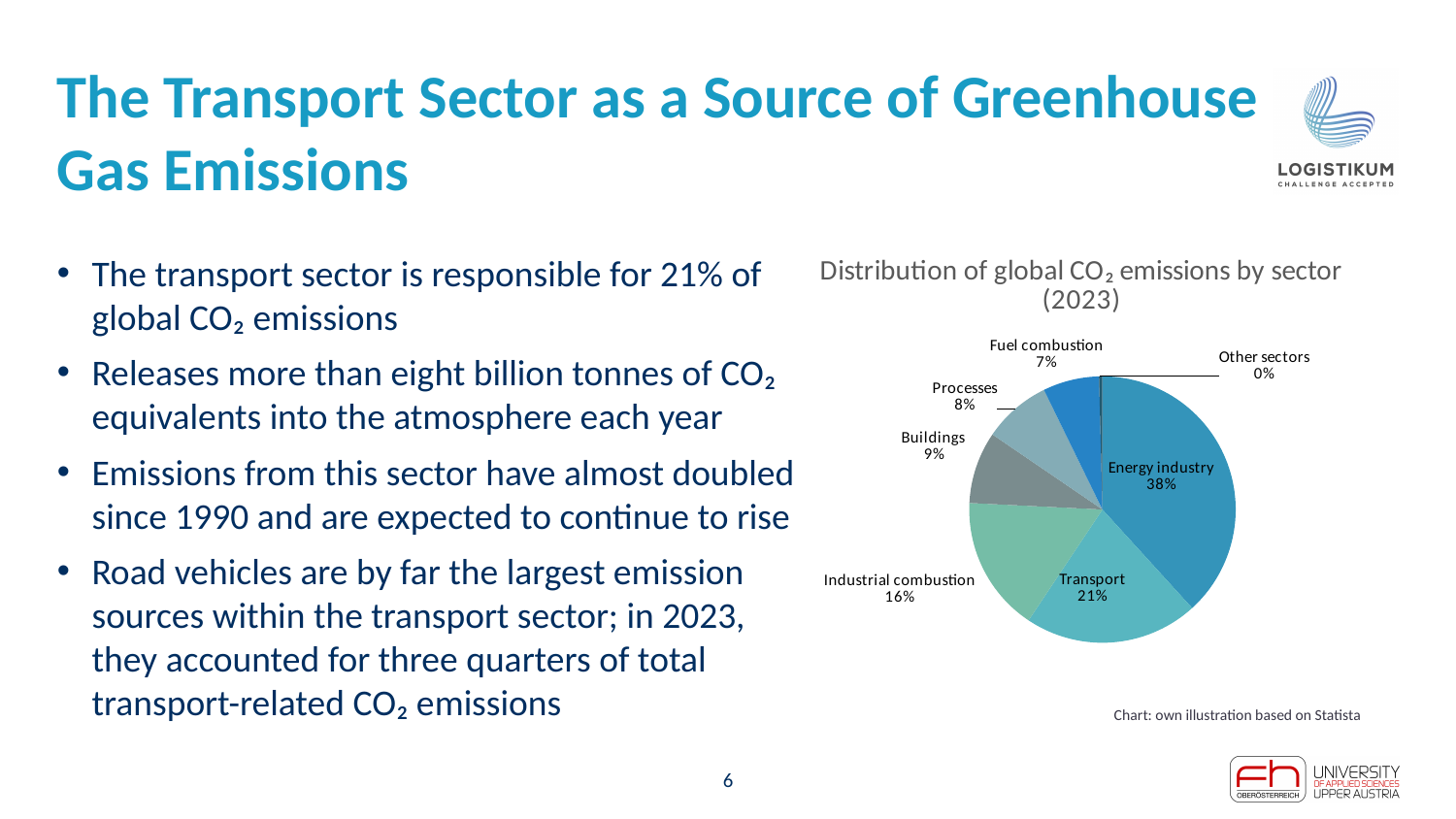
Which has a larger share, Processes or Buildings? Buildings How many sectors are shown in the pie chart? 7 What share of global CO₂ emissions does Industrial combustion account for? 16% What type of chart is shown on the slide? Pie chart What share of global CO₂ emissions does the Energy industry account for? 38% What is the title of the chart? Distribution of global CO₂ emissions by sector (2023) What share of global CO₂ emissions does Transport account for? 21% What is the difference in percentage points between the Energy industry and Transport shares? 17 percentage points Which sector has the largest share of global CO₂ emissions? Energy industry What share of global CO₂ emissions do Buildings account for? 9% Which sector has the smallest share of global CO₂ emissions? Other sectors What share of global CO₂ emissions does Fuel combustion account for? 7%